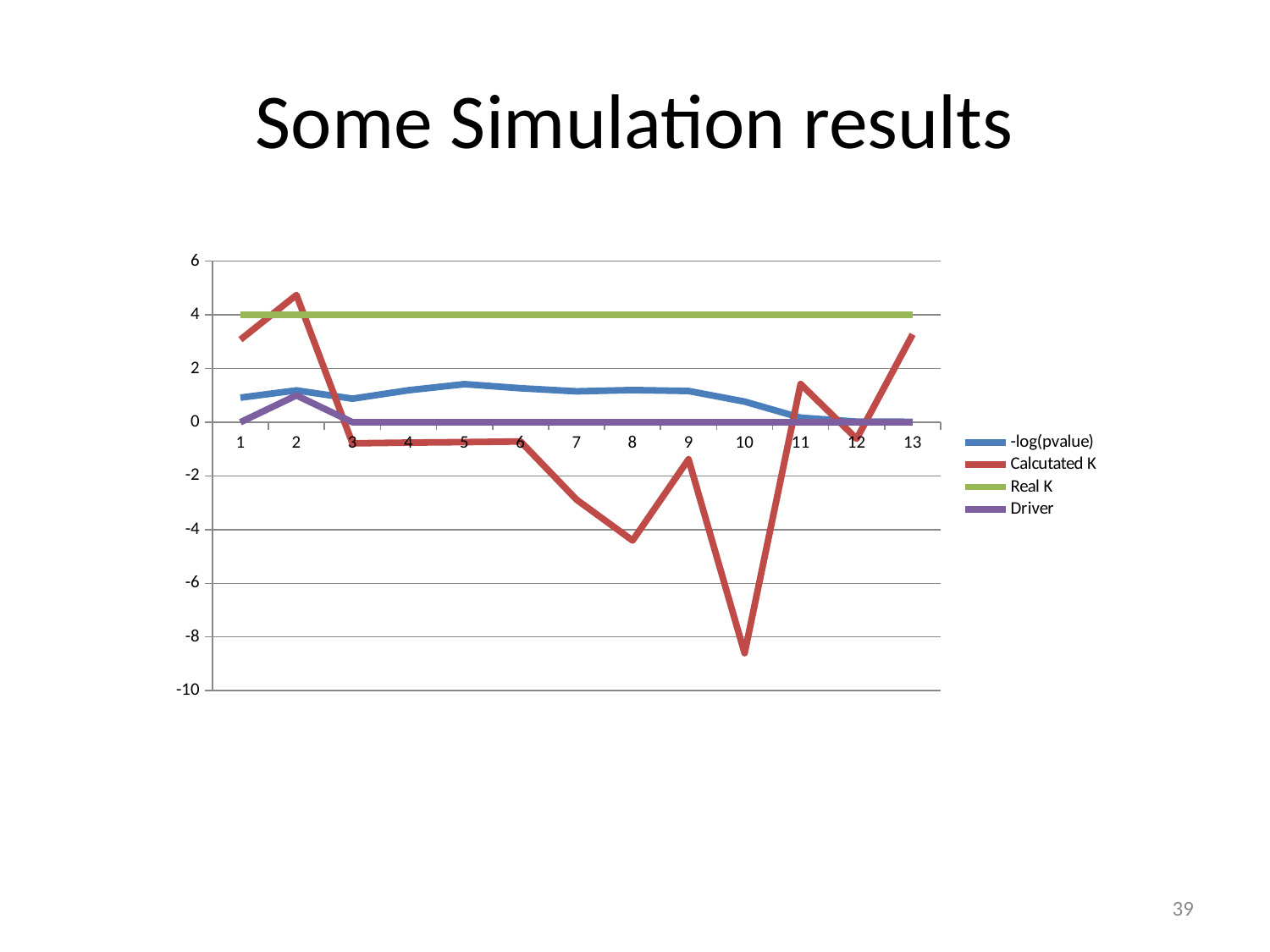
What is the value of Real K at point 5? 4 At which x-axis point does Calcutated K reach its highest value? 2 What colour is the Real K line in the legend? green What kind of chart is shown on the slide? line chart How many points are plotted along the x axis? 13 What is the value of Driver at point 7? 0 How many series does the legend list? 4 At point 1, which is larger: Real K or Calcutated K? Real K Is the value of Calcutated K at point 10 greater or less than -8? less Does -log(pvalue) rise or fall from point 9 to point 12? fall At which x-axis point does Calcutated K reach its lowest value? 10 Is the value of Calcutated K at point 2 greater or less than 4? greater